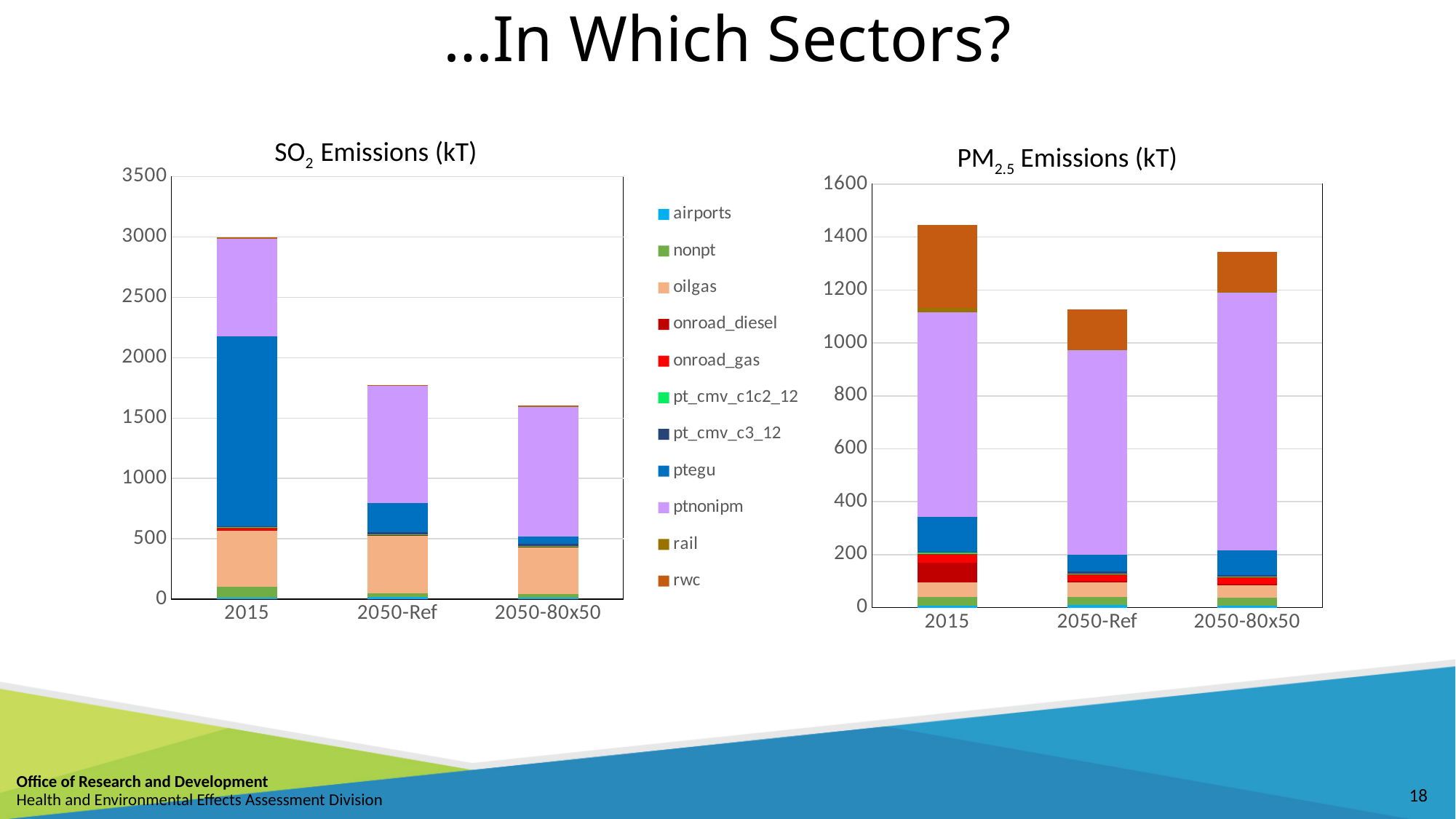
In the SO2 Emissions (kT) chart, which category has the highest total bar? 2015 How many categories are shown on the x axis of the PM2.5 Emissions (kT) chart? 3 In the PM2.5 Emissions (kT) chart, which category has the lowest total bar? 2050-Ref How many series does the legend list? 11 What kind of chart is the SO2 Emissions (kT) chart? stacked bar chart In the SO2 Emissions (kT) chart, is the total for 2050-Ref greater or less than 2000? less In the SO2 Emissions (kT) chart, which category has the lowest total bar? 2050-80x50 In the PM2.5 Emissions (kT) chart, is the total for 2050-80x50 greater or less than 1200? greater In the SO2 Emissions (kT) chart, which series makes up the largest segment of the 2015 bar? ptegu In the SO2 Emissions (kT) chart, do the total bars rise or fall from 2015 to 2050-80x50? fall In the PM2.5 Emissions (kT) chart, which category has the highest total bar? 2015 In the PM2.5 Emissions (kT) chart, which total bar is larger, 2050-Ref or 2050-80x50? 2050-80x50